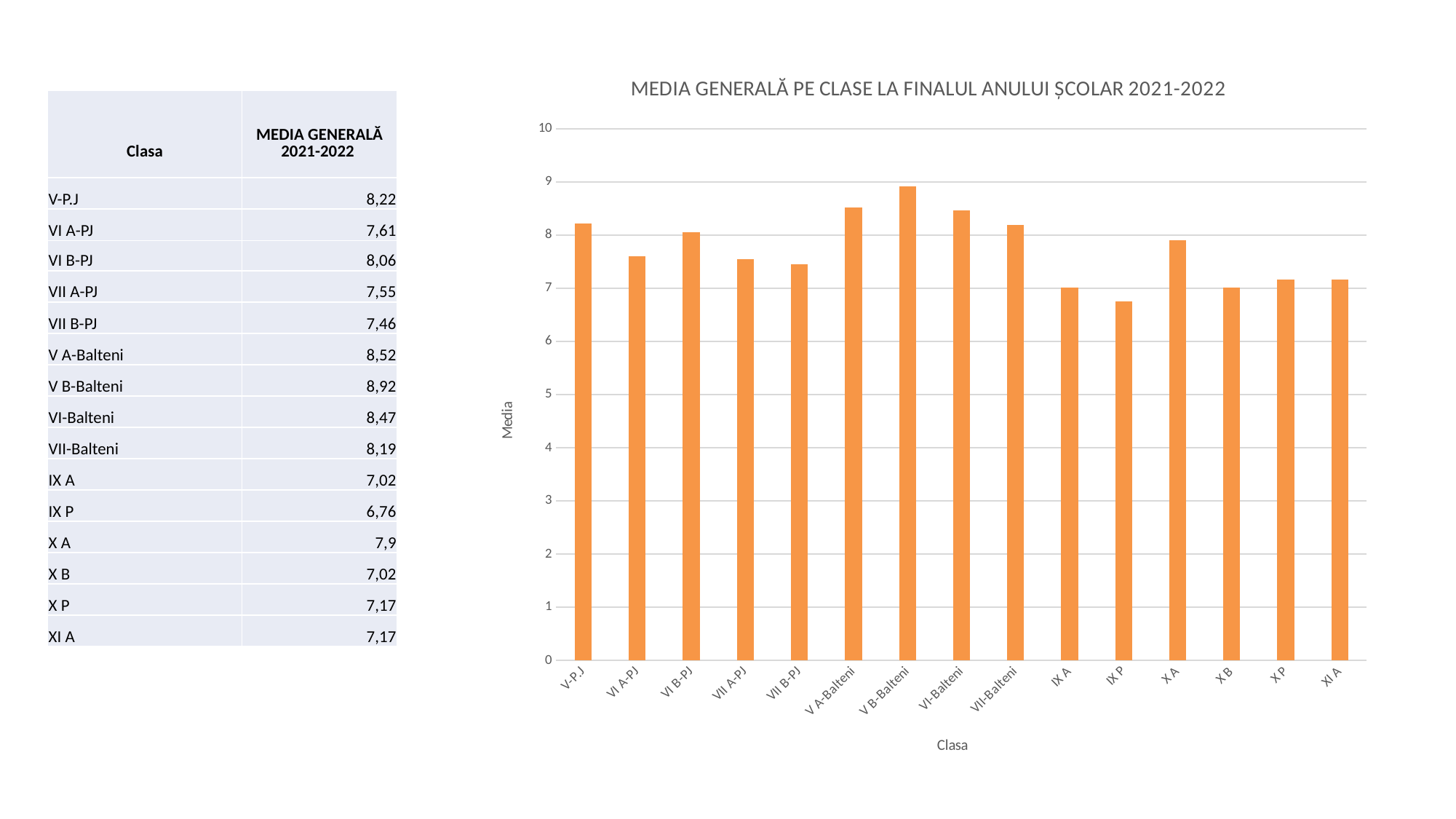
What is the average (media generală) for V B-Balteni? 8,92 Which class has the highest average on the chart? V B-Balteni Which has a higher average, V A-Balteni or VI-Balteni? V A-Balteni Which class has the lowest average on the chart? IX P What type of chart is shown on the slide? bar chart What is the average (media generală) for IX P? 6,76 How many classes (categories) are plotted on the chart? 15 Is the value for VII B-PJ greater or less than 8? less What is the label of the vertical axis of the chart? Media What is the average (media generală) for X A? 7,9 What is the title of the chart? MEDIA GENERALĂ PE CLASE LA FINALUL ANULUI ȘCOLAR 2021-2022 What is the difference between the averages of V B-Balteni and IX P? 2,16